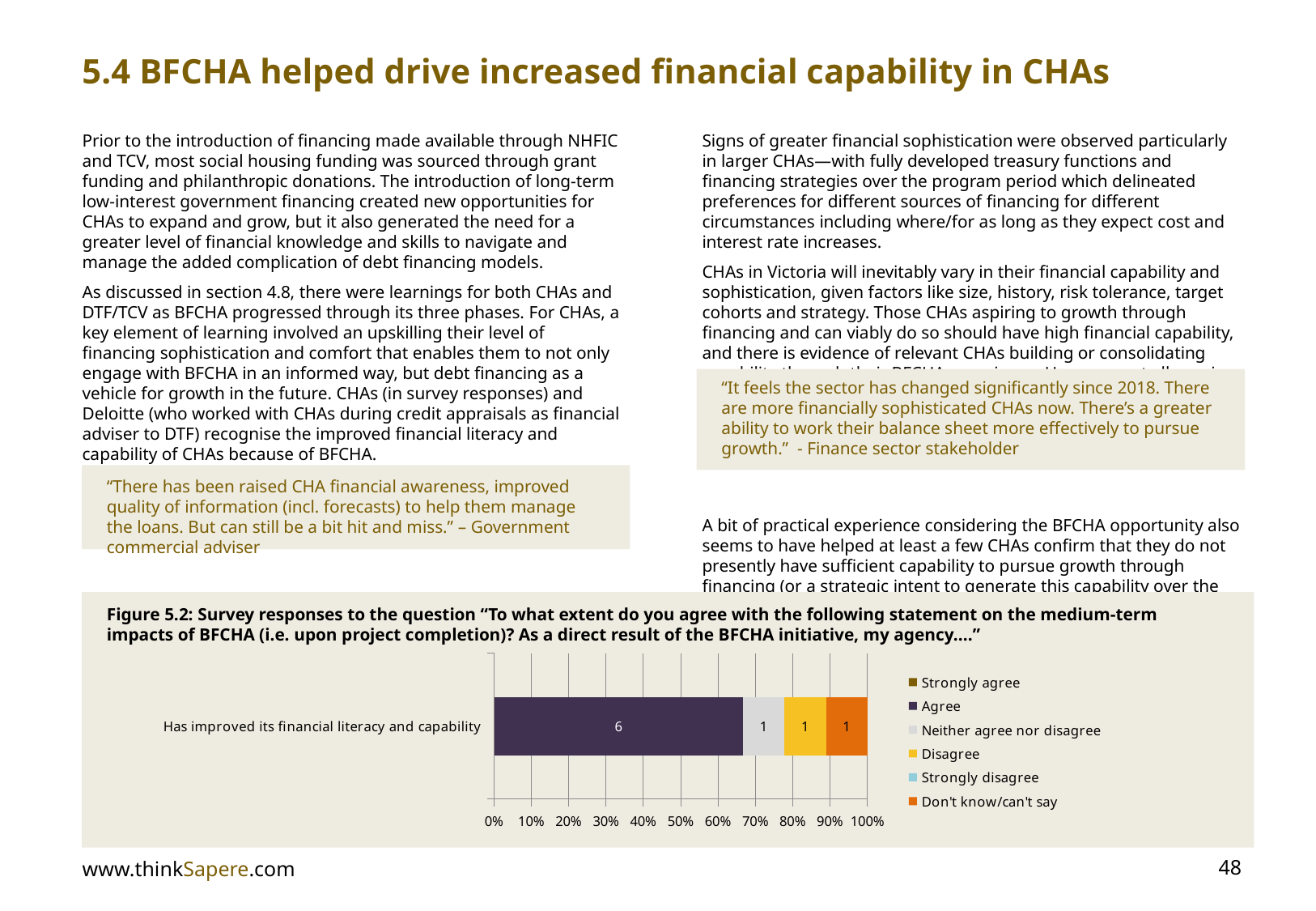
Does the Agree segment end at a share greater or less than 50% on the axis? greater Which response category has the largest segment in the bar? Agree What kind of chart is shown in Figure 5.2? Stacked bar chart How many series does the legend list? 6 What is the value of the Agree segment for "Has improved its financial literacy and capability"? 6 Which is larger, the Agree segment or the Neither agree nor disagree segment? Agree What is the value of the Don't know/can't say segment? 1 How many categories (bars) are plotted in the chart? 1 What is the difference between the Agree value and the Disagree value? 5 What is the value of the Neither agree nor disagree segment? 1 What is the total of the labelled segments in the bar? 9 What is the value of the Disagree segment? 1